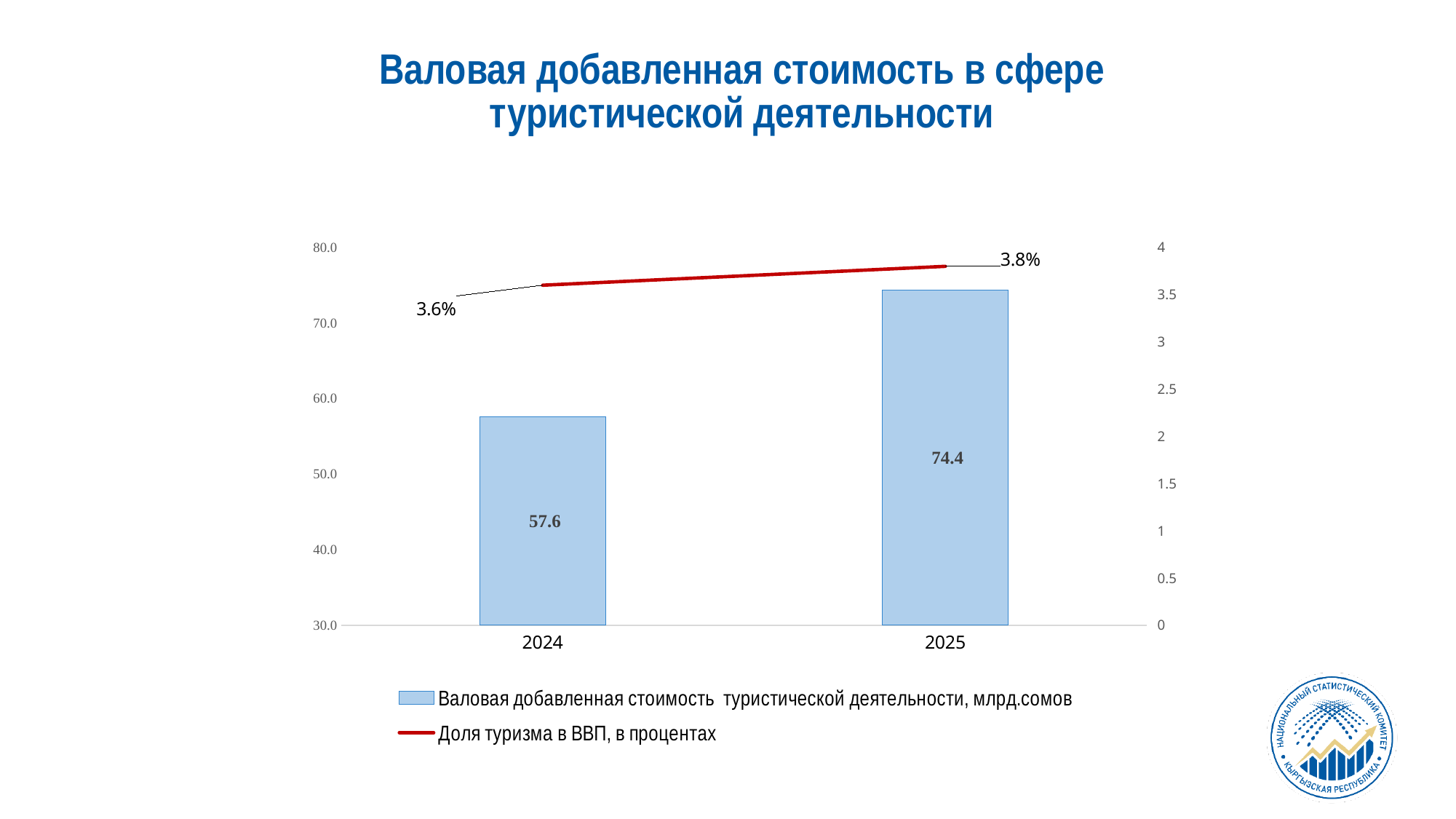
Which year has the higher gross value added of tourism activity? 2025 What colour is the line for the share of tourism in GDP? red What is the gross value added of tourism activity (млрд.сомов) for 2025? 74.4 How many series does the legend list? 2 What is the gross value added of tourism activity (млрд.сомов) for 2024? 57.6 How many years are shown on the x axis? 2 What is the share of tourism in GDP (Доля туризма в ВВП) for 2024? 3.6% Is the gross value added of tourism activity for 2024 greater or less than 60.0? less What is the share of tourism in GDP (Доля туризма в ВВП) for 2025? 3.8% Does the share of tourism in GDP rise or fall from 2024 to 2025? rise By how much did the gross value added of tourism activity increase from 2024 to 2025 (млрд.сомов)? 16.8 Which year has the lower share of tourism in GDP? 2024